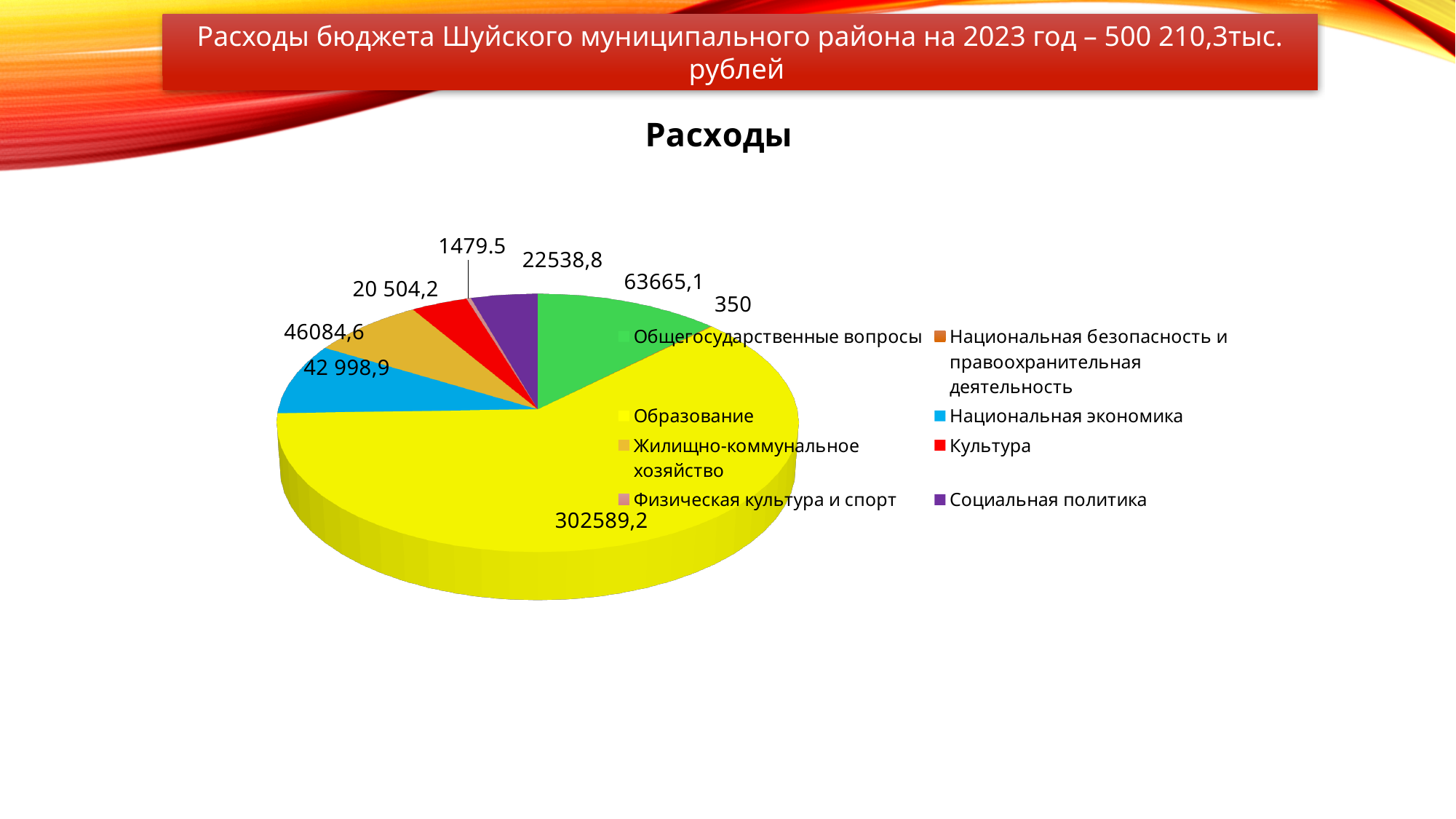
What is the difference between Общегосударственные вопросы and Жилищно-коммунальное хозяйство? 17580,5 Which category has the largest slice of the pie? Образование What is the value for Национальная экономика? 42 998,9 What is the title of the chart? Расходы What is the value for Образование? 302589,2 How many categories does the pie chart's legend list? 8 What type of chart is shown on the slide? Pie chart What is the value for Культура? 20 504,2 What is the value for Общегосударственные вопросы? 63665,1 Which category has the smallest value? Национальная безопасность и правоохранительная деятельность What is the value for Социальная политика? 22538,8